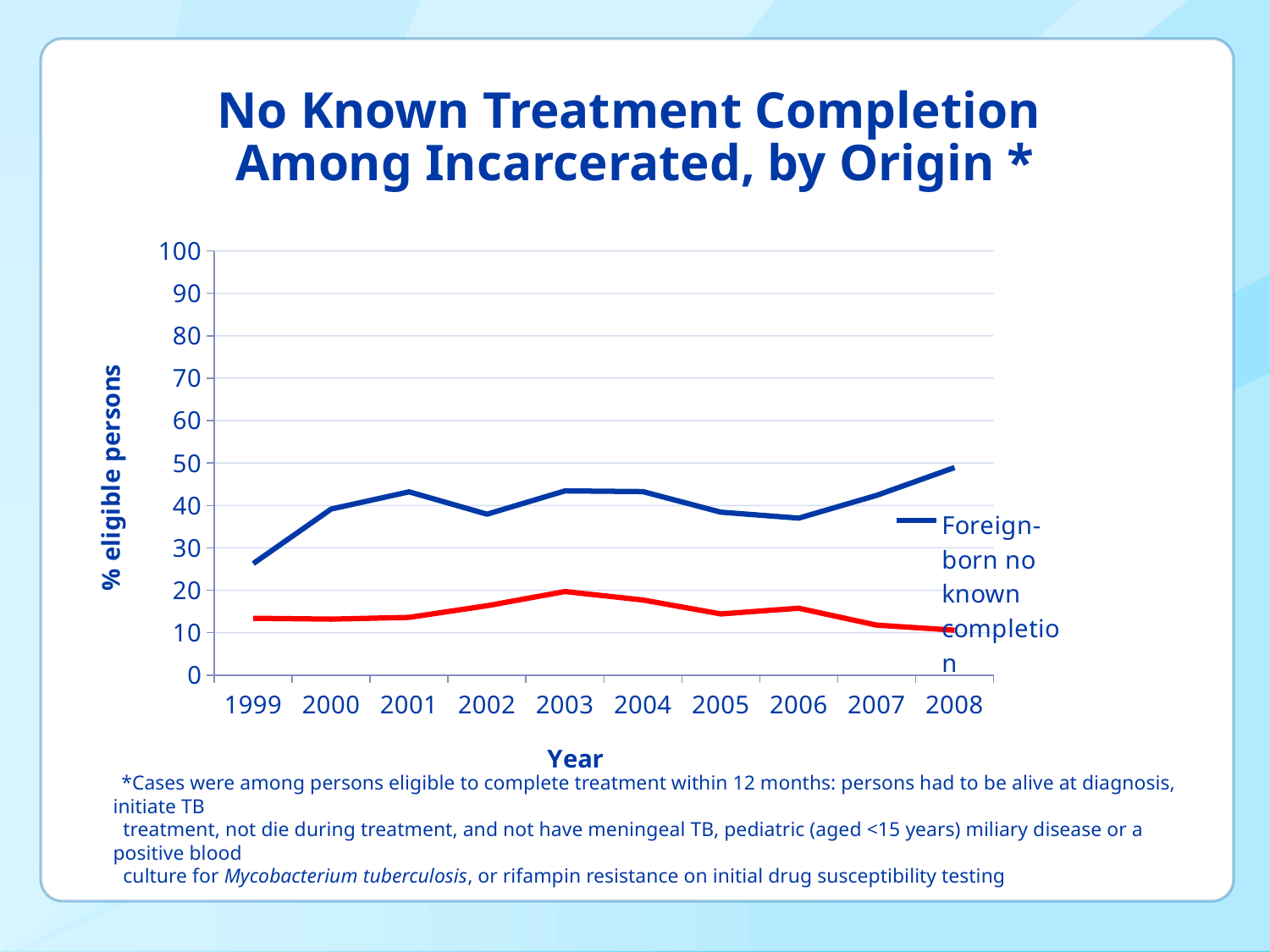
Does the Foreign-born no known completion line rise or fall from 2006 to 2008? rise Which year has the larger Foreign-born no known completion value, 2000 or 2008? 2008 In which year is the Foreign-born no known completion value highest? 2008 In which year is the Foreign-born no known completion value lowest? 1999 What kind of chart is shown on the slide? line chart Is the value for Foreign-born no known completion in 1999 greater or less than 30? less How many years are shown along the x axis? 10 Is the value for Foreign-born no known completion in 2008 greater or less than 40? greater What is the title of the y axis? % eligible persons What is the title of the x axis? Year Is the value for Foreign-born no known completion in 2006 greater or less than 30? greater